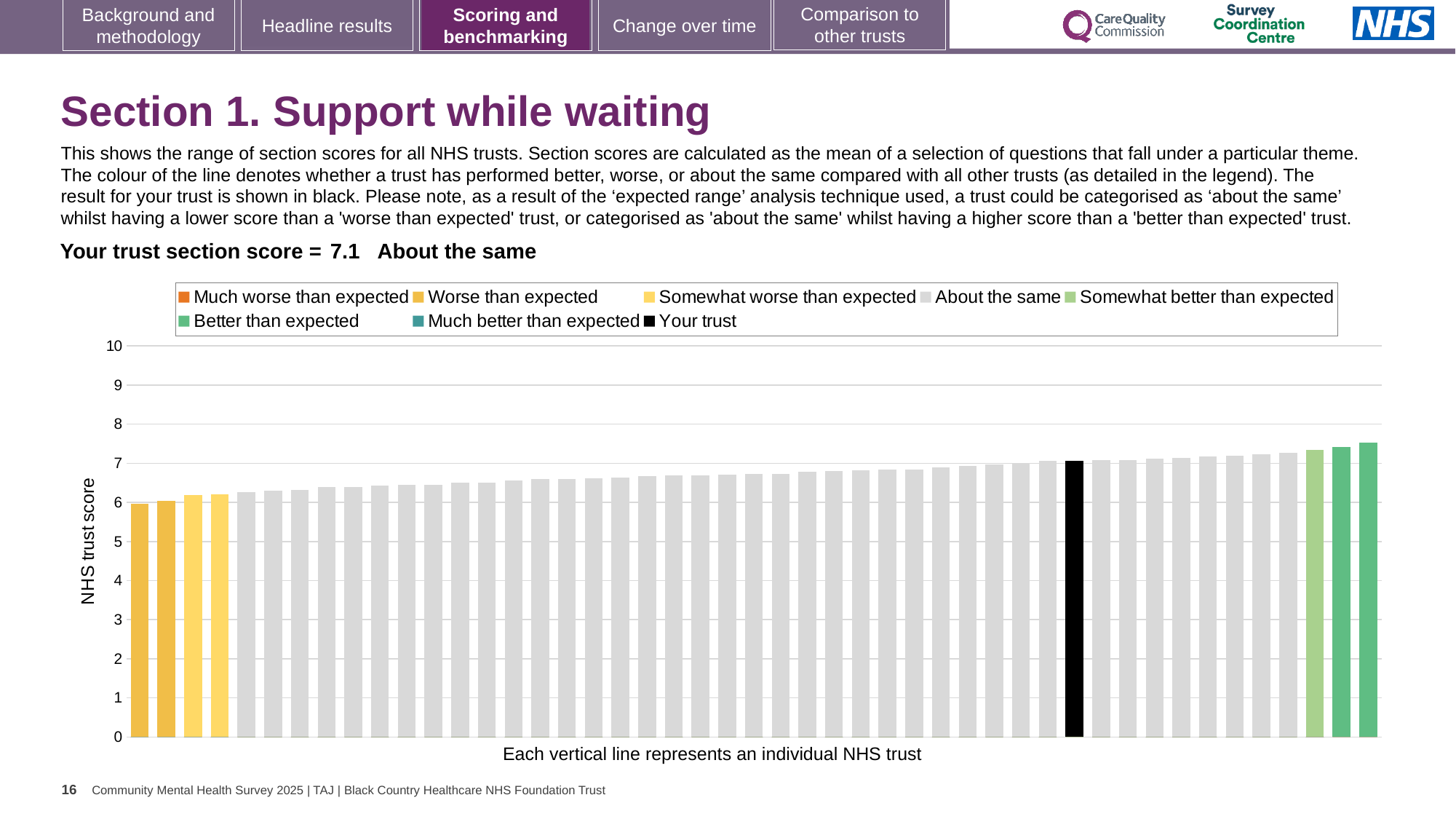
How many bars are coloured green (better than expected or somewhat better than expected)? 3 Is the value of the tallest bar greater or less than 8? less Is the value of the black 'Your trust' bar greater or less than 8? less Do the bar values rise or fall from left to right along the x axis? rise What is the section score for your trust shown on the slide? 7.1 Is the value of the leftmost bar greater or less than 7? less What colour is used for the 'Your trust' bar in the chart? black Which category is your trust placed in for this section? About the same What is the label on the vertical axis of the chart? NHS trust score What kind of chart is shown on the slide? bar chart How many entries does the chart legend list? 8